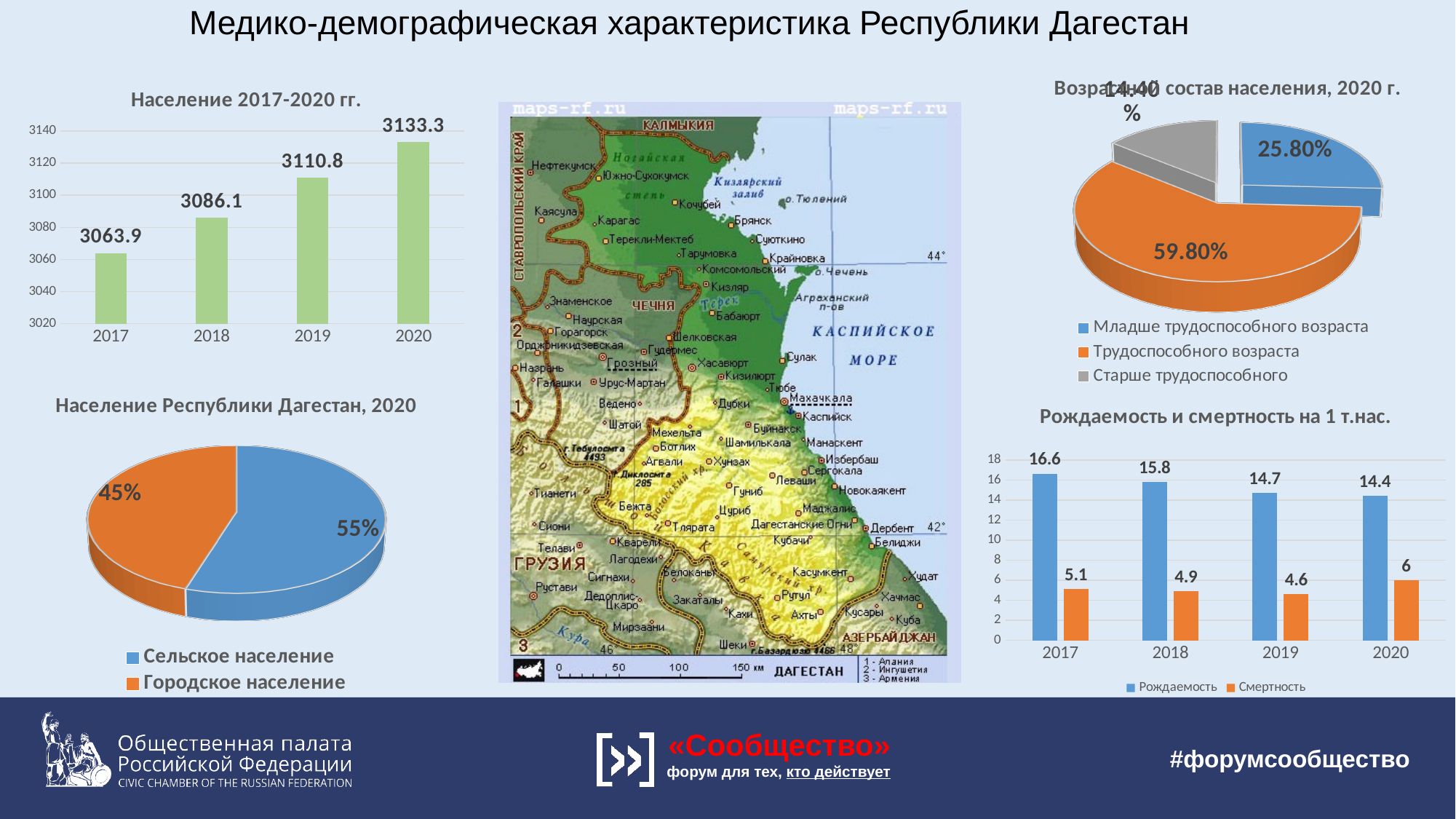
In the chart 'Рождаемость и смертность на 1 т.нас.', what is the value of Смертность in 2020? 6 In the pie chart 'Возрастной состав населения, 2020 г.', how many categories does the legend list? 3 In the pie chart 'Население Республики Дагестан, 2020', what share is Сельское население? 55% In the pie chart 'Население Республики Дагестан, 2020', which is larger: Сельское население or Городское население? Сельское население In the chart 'Население 2017-2020 гг.', how many years are plotted? 4 In the chart 'Население 2017-2020 гг.', which year has the lowest value? 2017 In the chart 'Население 2017-2020 гг.', do the values rise or fall from 2017 to 2020? rise What kind of chart is 'Рождаемость и смертность на 1 т.нас.'? bar chart In the chart 'Население 2017-2020 гг.', what is the value for 2019? 3110.8 In the chart 'Рождаемость и смертность на 1 т.нас.', what is the value of Рождаемость in 2018? 15.8 In the chart 'Население 2017-2020 гг.', what is the difference between the 2020 and 2017 values? 69.4 In the pie chart 'Возрастной состав населения, 2020 г.', what share is Трудоспособного возраста? 59.80%